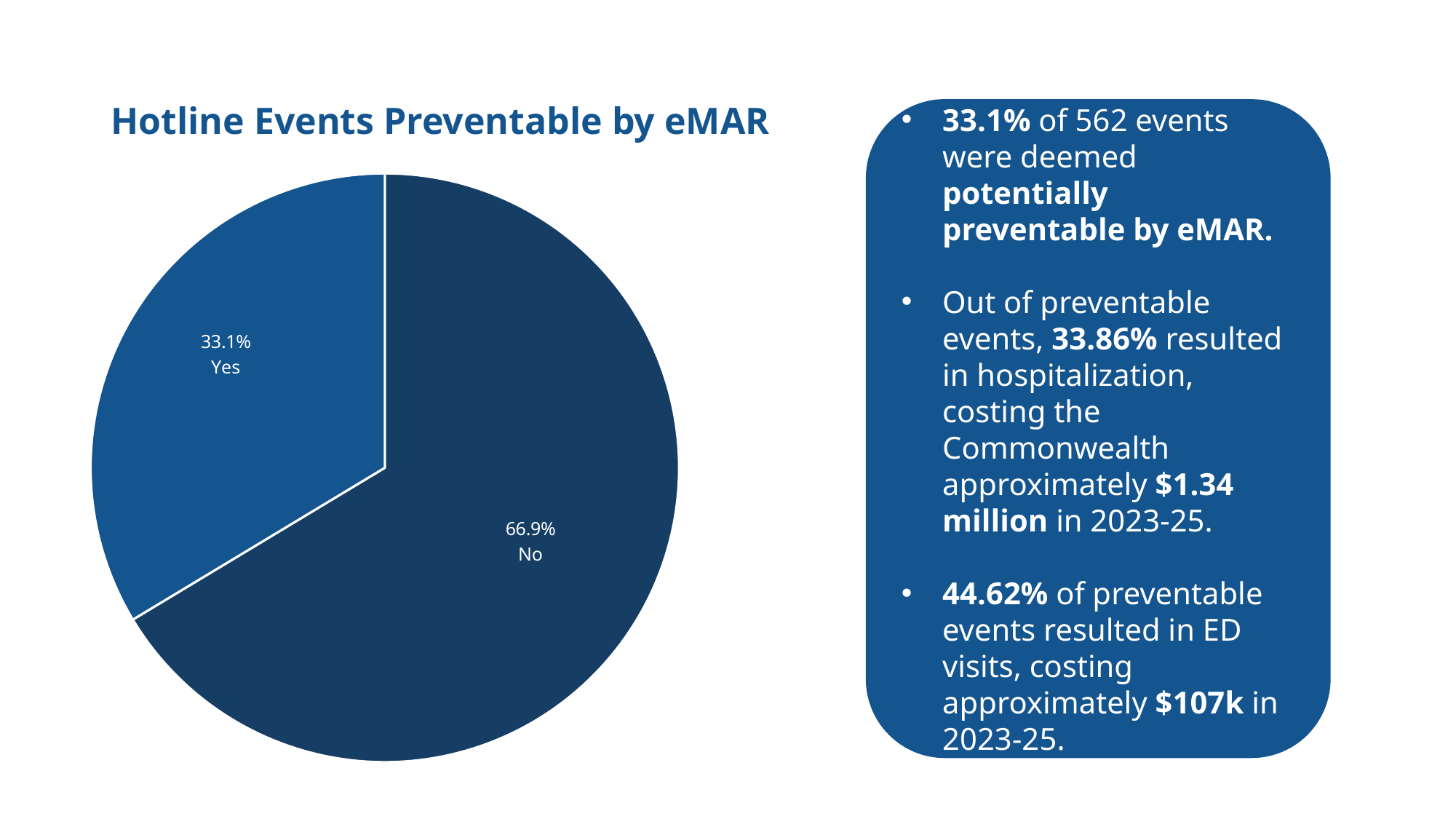
Which slice is larger, "Yes" or "No"? No What is the title of the pie chart? Hotline Events Preventable by eMAR What percentage of hotline events are labelled "Yes" (preventable by eMAR)? 33.1% Which slice of the pie chart is the smallest? Yes What percentage of hotline events are labelled "No"? 66.9% Which slice of the pie chart is the largest? No How many slices does the pie chart have? 2 What is the difference in percentage points between the "No" and "Yes" slices? 33.8 What share of the pie does the "Yes" slice represent? 33.1% Is the "No" slice greater or less than 50% of the pie? greater What kind of chart is shown on the slide? pie chart Which slice of the pie chart is shown in the lighter blue colour? Yes